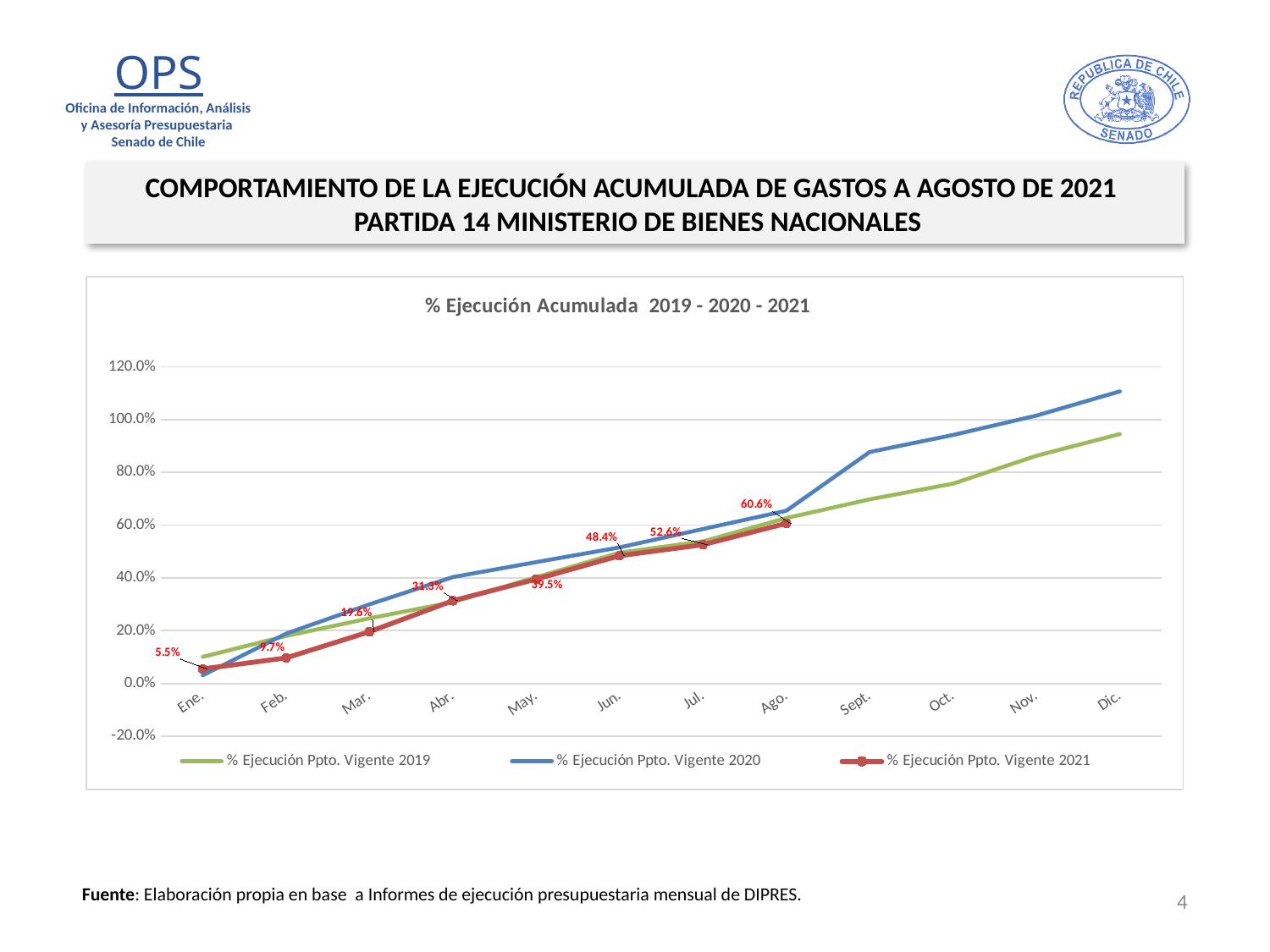
Is the value for % Ejecución Ppto. Vigente 2020 in Dic. greater or less than 100.0%? greater What is the value for % Ejecución Ppto. Vigente 2021 in Ago.? 60.6% In which month does the % Ejecución Ppto. Vigente 2021 series reach its highest labelled value? Ago. Do the values for % Ejecución Ppto. Vigente 2021 rise or fall from Ene. to Ago.? Rise What is the value for % Ejecución Ppto. Vigente 2021 in May.? 39.5% What is the value for % Ejecución Ppto. Vigente 2021 in Ene.? 5.5% Which series is higher in Dic., % Ejecución Ppto. Vigente 2019 or % Ejecución Ppto. Vigente 2020? % Ejecución Ppto. Vigente 2020 What kind of chart is shown on the slide? Line chart How many series does the legend list? 3 By how many percentage points did % Ejecución Ppto. Vigente 2021 increase from Jul. to Ago.? 8.0 percentage points By how many percentage points did % Ejecución Ppto. Vigente 2021 increase from Mar. to Abr.? 11.7 percentage points How many months are shown along the x axis? 12